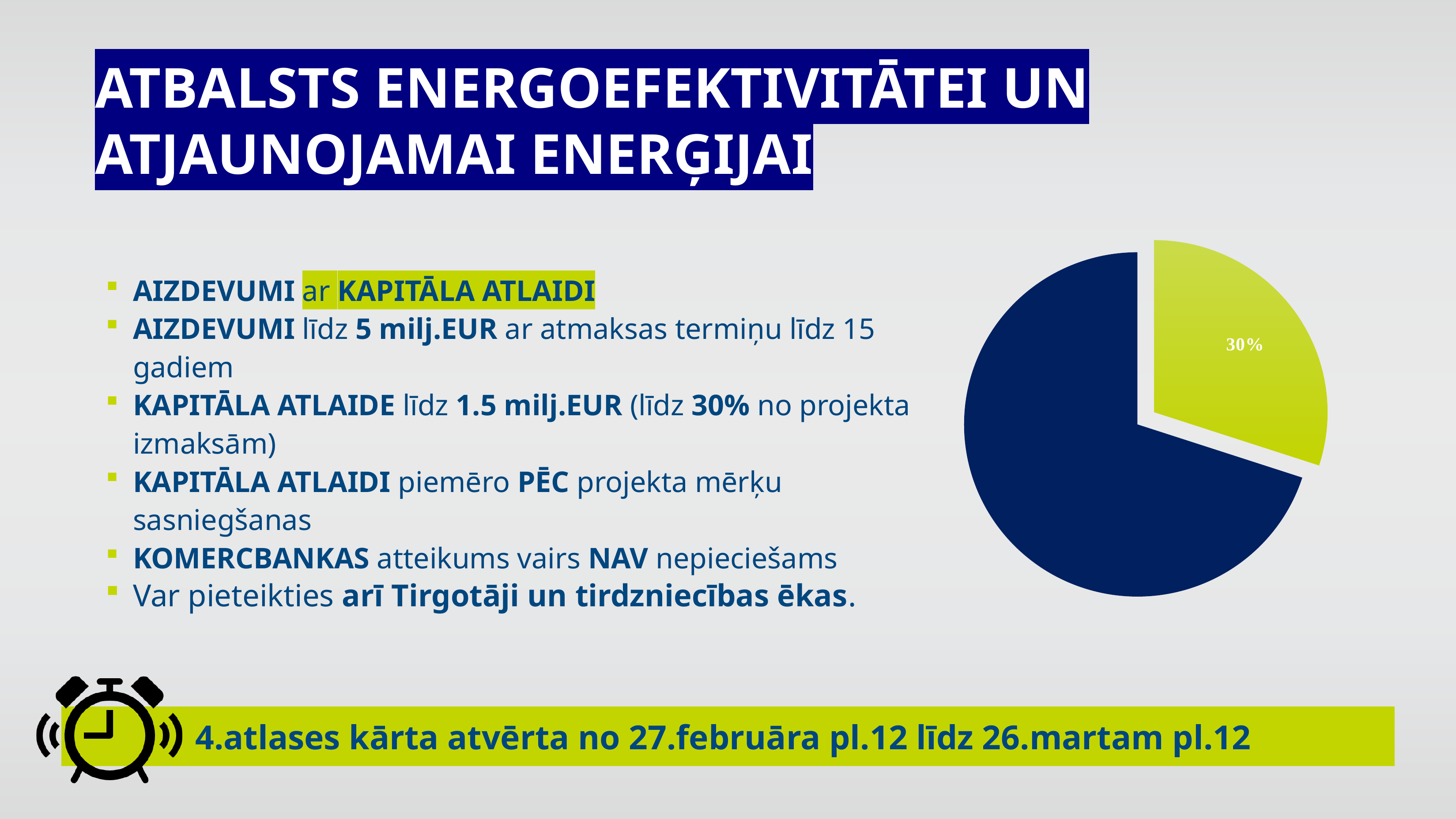
What value is printed on the green slice of the pie chart? 30% Is the share of the green slice in the pie chart greater or less than 50%? less Which slice of the pie chart is pulled out (exploded) from the rest of the pie? the green slice How many slices does the pie chart have? 2 Which slice of the pie chart is the smallest? the green slice Which is larger in the pie chart, the dark blue slice or the green slice? the dark blue slice What kind of chart is shown on the right side of the slide? pie chart What share of the pie does the green slice represent? 30% Which slice of the pie chart is the largest? the dark blue slice What share of the pie does the dark blue slice represent? 70% How many slices in the pie chart have a printed data label? 1